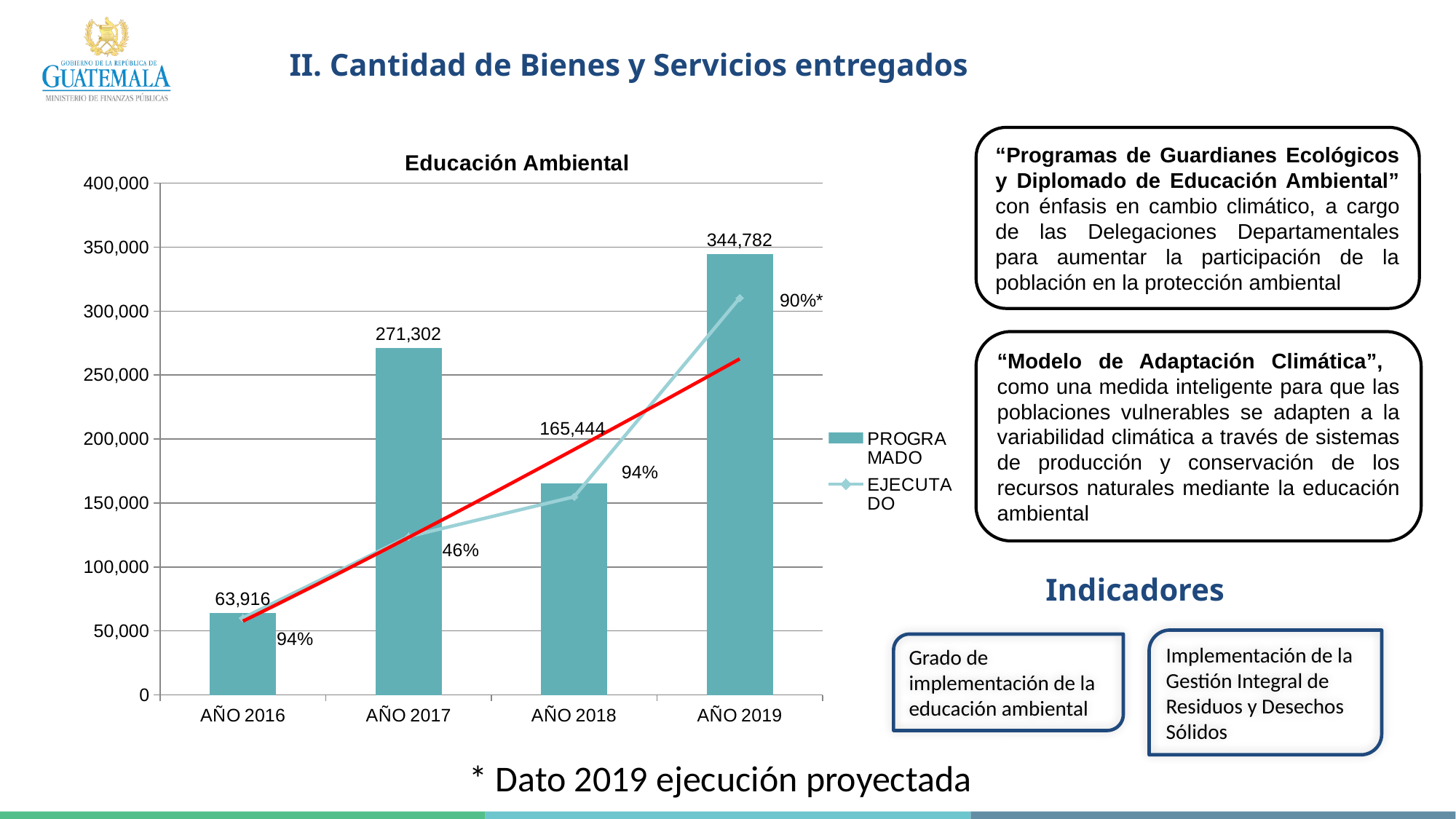
What is the PROGRAMADO value for AÑO 2016? 63,916 What is the difference between the PROGRAMADO values for AÑO 2019 and AÑO 2018? 179,338 What is the PROGRAMADO value for AÑO 2017? 271,302 What kind of chart is used to show the PROGRAMADO values? Bar chart What percentage label is shown for EJECUTADO in AÑO 2019? 90%* What is the PROGRAMADO value for AÑO 2019? 344,782 Which year has the lowest PROGRAMADO value? AÑO 2016 How many series does the chart legend list? 2 Which year has the highest PROGRAMADO value? AÑO 2019 What is the title of the chart on the slide? Educación Ambiental Which is larger, the PROGRAMADO value for AÑO 2017 or for AÑO 2018? AÑO 2017 What percentage label is shown for EJECUTADO in AÑO 2017? 46%